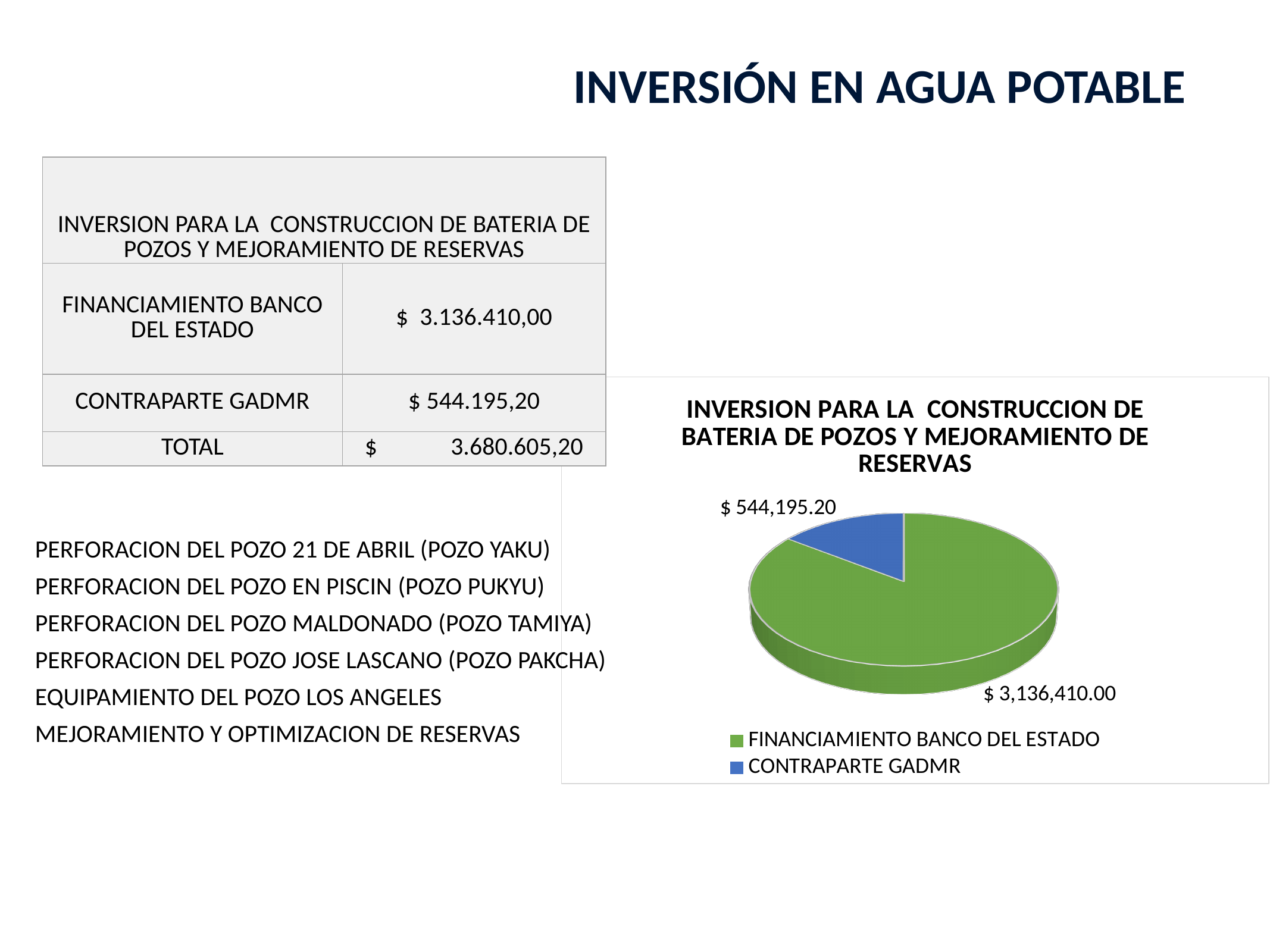
What colour is the CONTRAPARTE GADMR slice in the pie chart? Blue How many entries does the legend of the pie chart list? 2 What is the value for CONTRAPARTE GADMR in the pie chart? $ 544,195.20 What is the total of the two slices in the pie chart? $ 3,680,605.20 Which category has the largest slice in the pie chart? FINANCIAMIENTO BANCO DEL ESTADO Which category has the smallest slice in the pie chart? CONTRAPARTE GADMR What is the difference between the FINANCIAMIENTO BANCO DEL ESTADO and CONTRAPARTE GADMR values in the pie chart? $ 2,592,214.80 What is the value for FINANCIAMIENTO BANCO DEL ESTADO in the pie chart? $ 3,136,410.00 How many slices does the pie chart have? 2 Which is larger in the pie chart, FINANCIAMIENTO BANCO DEL ESTADO or CONTRAPARTE GADMR? FINANCIAMIENTO BANCO DEL ESTADO What kind of chart is shown on the slide? Pie chart